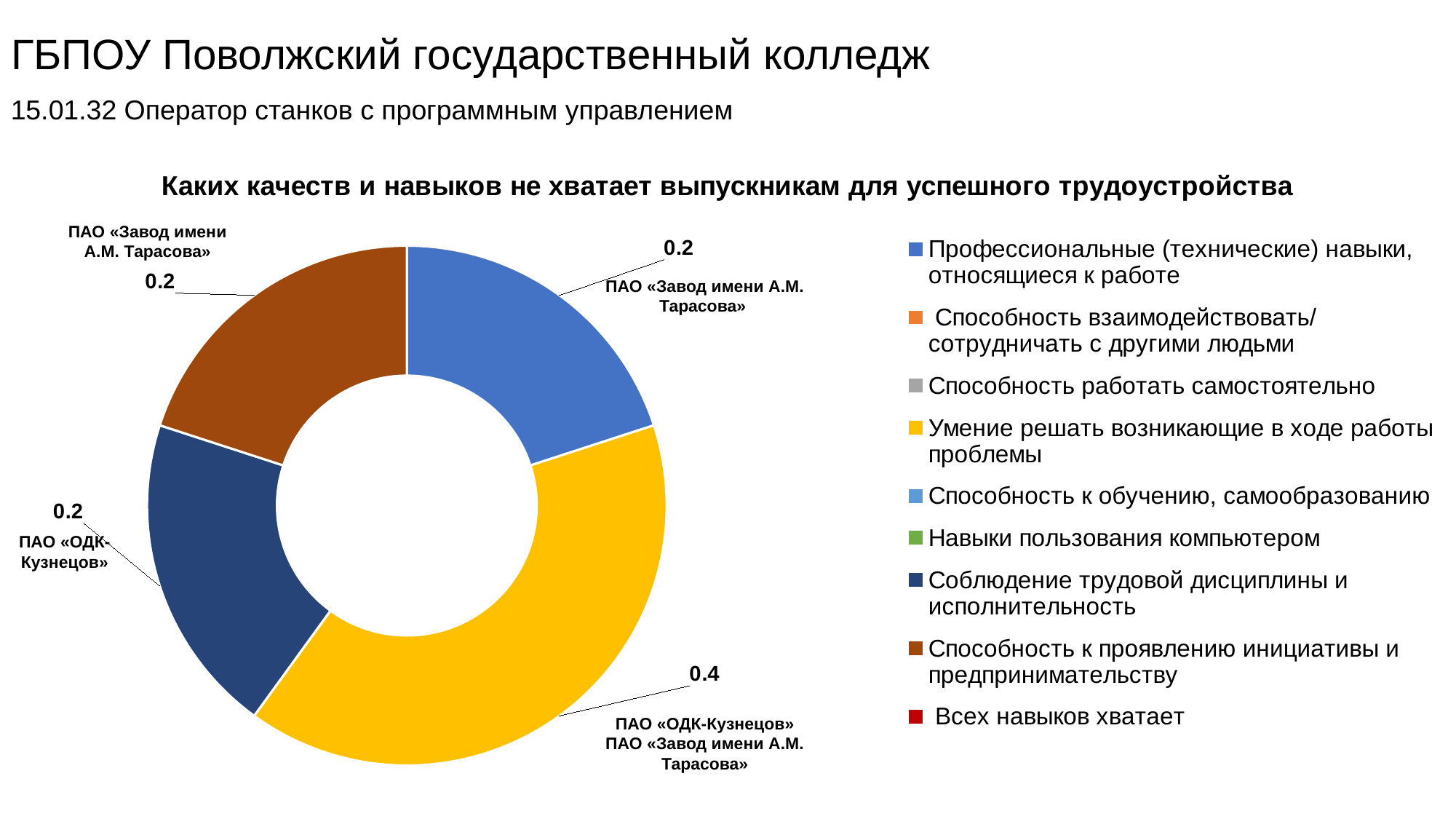
How many entries does the chart legend list? 9 Which is larger: the slice for «Умение решать возникающие в ходе работы проблемы» or the slice for «Способность к проявлению инициативы и предпринимательству»? Умение решать возникающие в ходе работы проблемы Which category has the largest slice in the chart? Умение решать возникающие в ходе работы проблемы What is the value of the slice for «Способность к проявлению инициативы и предпринимательству»? 0.2 What kind of chart is shown on the slide? Doughnut (pie) chart What is the title of the chart? Каких качеств и навыков не хватает выпускникам для успешного трудоустройства What is the difference between the value for «Умение решать возникающие в ходе работы проблемы» and the value for «Соблюдение трудовой дисциплины и исполнительность»? 0.2 Which employers are labelled next to the 0.4 slice? ПАО «ОДК-Кузнецов» and ПАО «Завод имени А.М. Тарасова» What is the value of the slice for «Соблюдение трудовой дисциплины и исполнительность»? 0.2 How many slices with data labels are visible in the doughnut chart? 4 What is the value of the slice for «Профессиональные (технические) навыки, относящиеся к работе»? 0.2 What is the value of the slice for «Умение решать возникающие в ходе работы проблемы»? 0.4